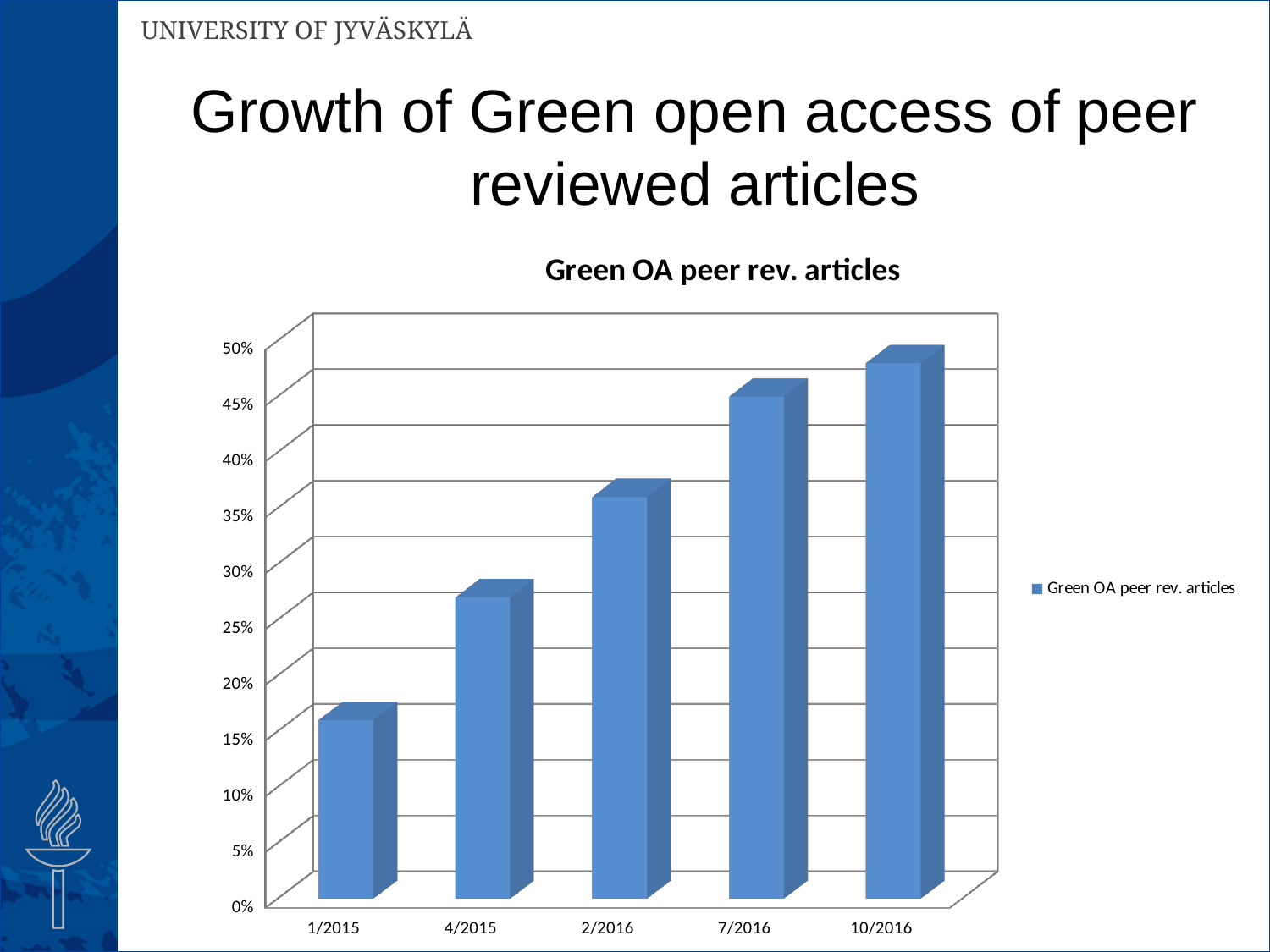
What kind of chart is shown on the slide? bar chart How many series does the chart legend list? 1 How many time periods are shown on the x axis of the chart? 5 Which period has the highest share of Green OA peer reviewed articles? 10/2016 Is the value for 4/2015 greater or less than 30%? less Which period has the lowest share of Green OA peer reviewed articles? 1/2015 Do the values rise or fall from 1/2015 to 10/2016? rise Is the value for 2/2016 greater or less than 30%? greater Is the value for 1/2015 greater or less than 20%? less What is the title of the chart? Green OA peer rev. articles